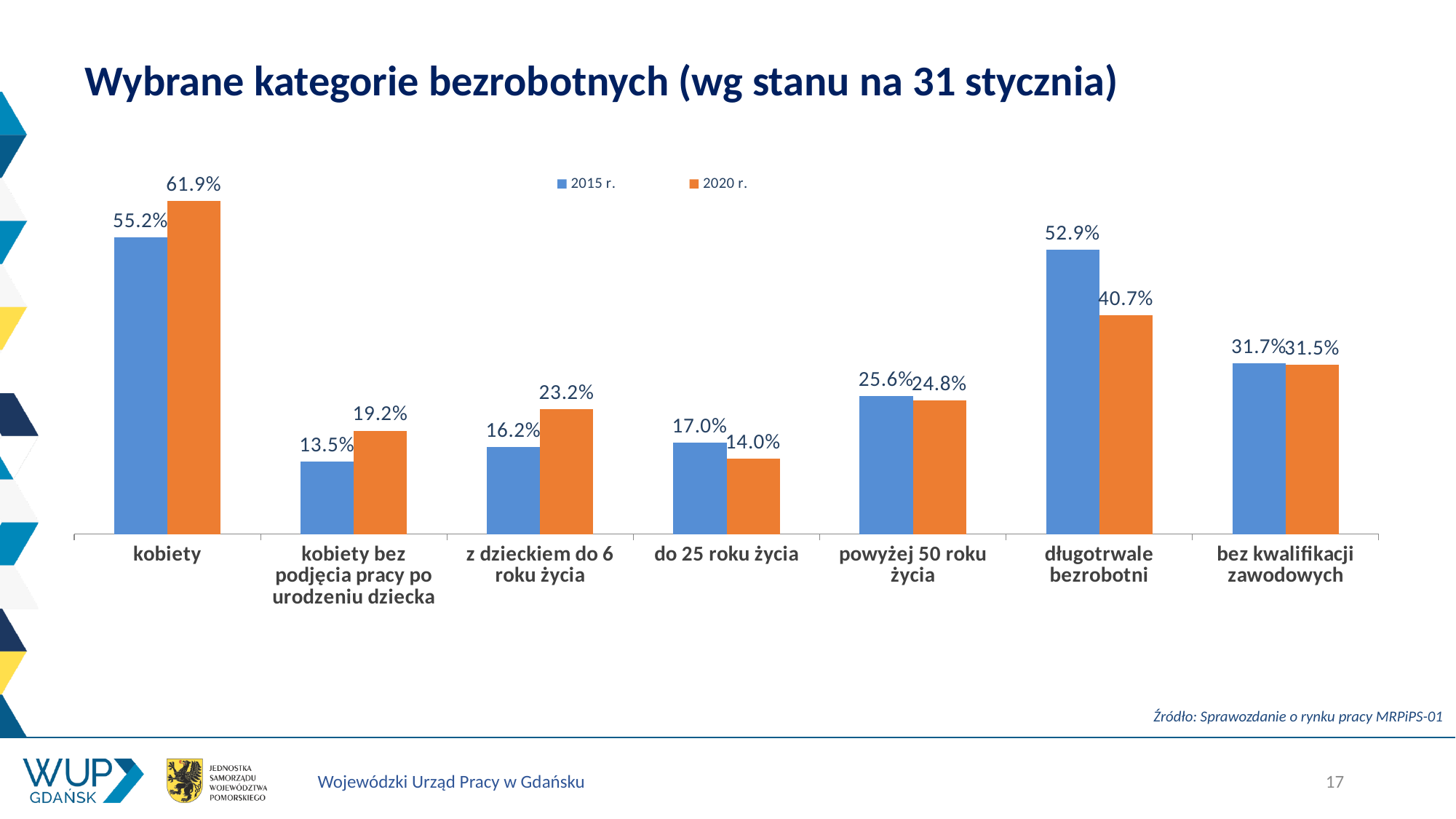
How many categories are shown on the x axis of the chart? 7 What is the value for "kobiety" in the 2020 r. series? 61.9% For "z dzieckiem do 6 roku życia", which series has the larger value, 2015 r. or 2020 r.? 2020 r. How many series does the legend list? 2 Which category has the highest value in the 2015 r. series? kobiety What is the difference between the 2020 r. and 2015 r. values for "kobiety"? 6.7 percentage points What is the difference between the 2020 r. and 2015 r. values for "długotrwale bezrobotni"? 12.2 percentage points What kind of chart is shown on the slide? bar chart For "do 25 roku życia", which series has the larger value, 2015 r. or 2020 r.? 2015 r. Which category has the lowest value in the 2020 r. series? do 25 roku życia What is the value for "do 25 roku życia" in the 2020 r. series? 14.0% What is the value for "długotrwale bezrobotni" in the 2015 r. series? 52.9%